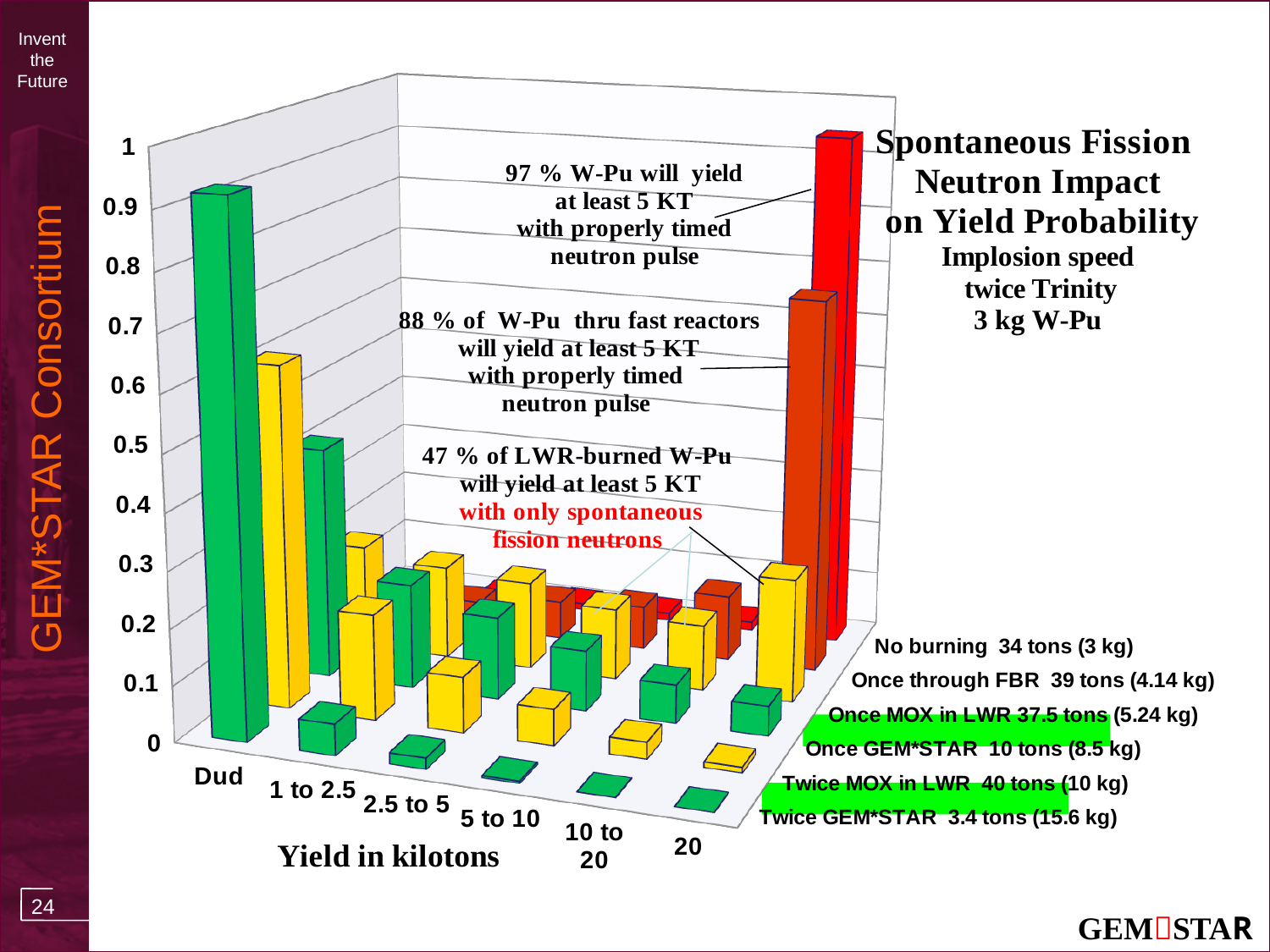
Is the value for Twice GEM*STAR in the 20 category greater or less than 0.1? less Is the value for No burning in the 20 category greater or less than 0.5? greater What is the label of the x axis? Yield in kilotons For the Twice GEM*STAR series, do the values generally rise or fall from Dud to 20 along the x axis? fall In the Dud category, which is larger: the value for Twice GEM*STAR or the value for Twice MOX in LWR? Twice GEM*STAR Is the value for Twice GEM*STAR in the Dud category greater or less than 0.5? greater What kind of chart is shown on the slide? bar chart For the Twice GEM*STAR series, which yield category has the highest bar? Dud How many fuel-burning series are plotted in the chart? 6 What is the title of the chart? Spontaneous Fission Neutron Impact on Yield Probability For the No burning series, which yield category has the highest bar? 20 How many yield categories are shown along the x axis? 6